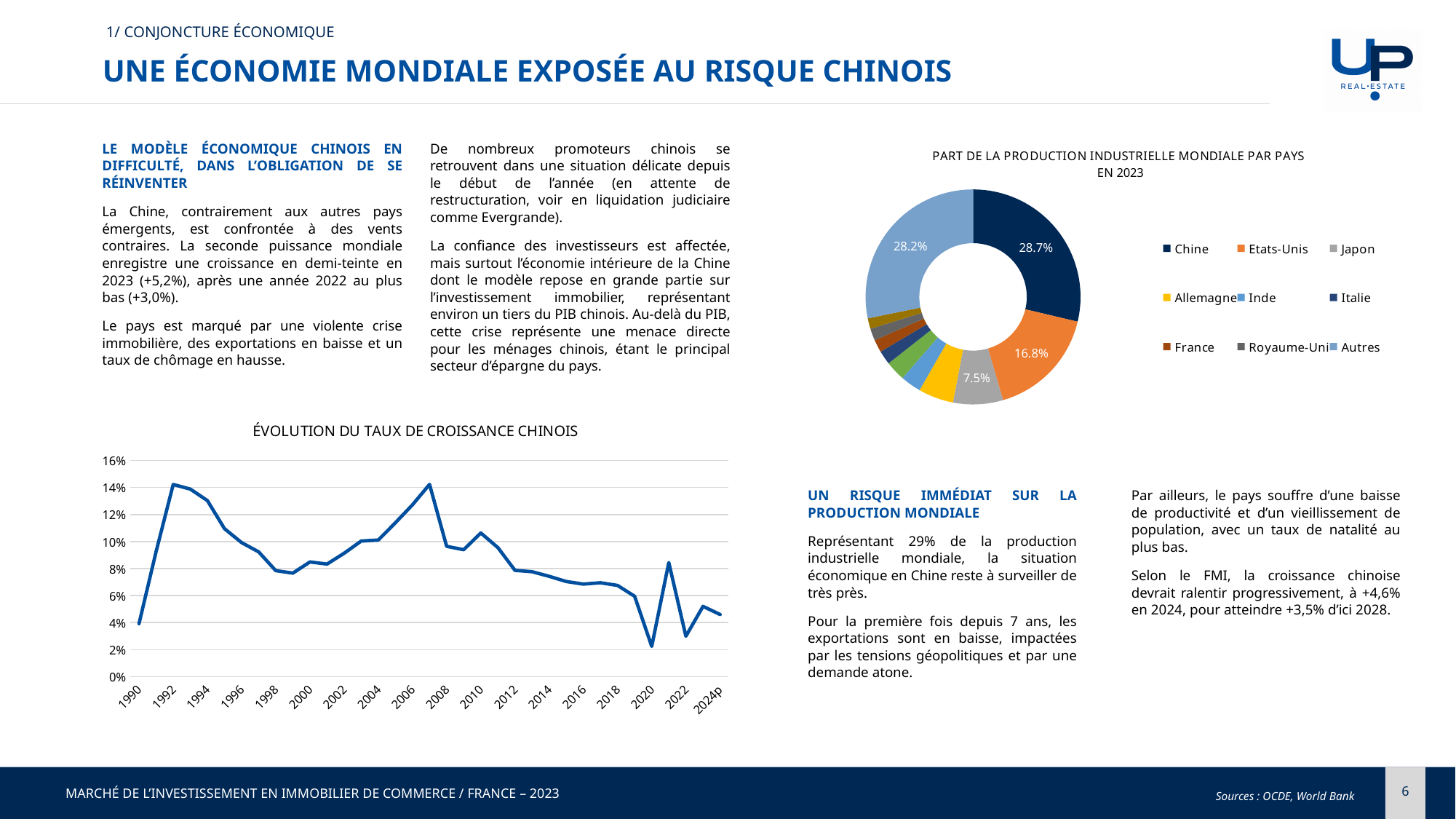
In the chart 'Évolution du taux de croissance chinois', is the value for 1992 greater or less than 12%? greater In the pie chart 'Part de la production industrielle mondiale par pays en 2023', what share is shown for Japon? 7.5% How many entries does the legend of the pie chart 'Part de la production industrielle mondiale par pays en 2023' list? 9 What kind of chart is 'Évolution du taux de croissance chinois'? Line chart What kind of chart is 'Part de la production industrielle mondiale par pays en 2023'? Doughnut chart In the pie chart 'Part de la production industrielle mondiale par pays en 2023', what share is shown for Chine? 28.7% In the chart 'Évolution du taux de croissance chinois', is the value for 2020 greater or less than 4%? less In the pie chart 'Part de la production industrielle mondiale par pays en 2023', which labelled country has the largest share? Chine In the pie chart 'Part de la production industrielle mondiale par pays en 2023', what share is shown for Etats-Unis? 16.8% In the pie chart 'Part de la production industrielle mondiale par pays en 2023', which has the larger share, Chine or Autres? Chine In the pie chart 'Part de la production industrielle mondiale par pays en 2023', what share is shown for Autres? 28.2% In the pie chart 'Part de la production industrielle mondiale par pays en 2023', what is the difference between the shares of Chine and Etats-Unis? 11.9 percentage points